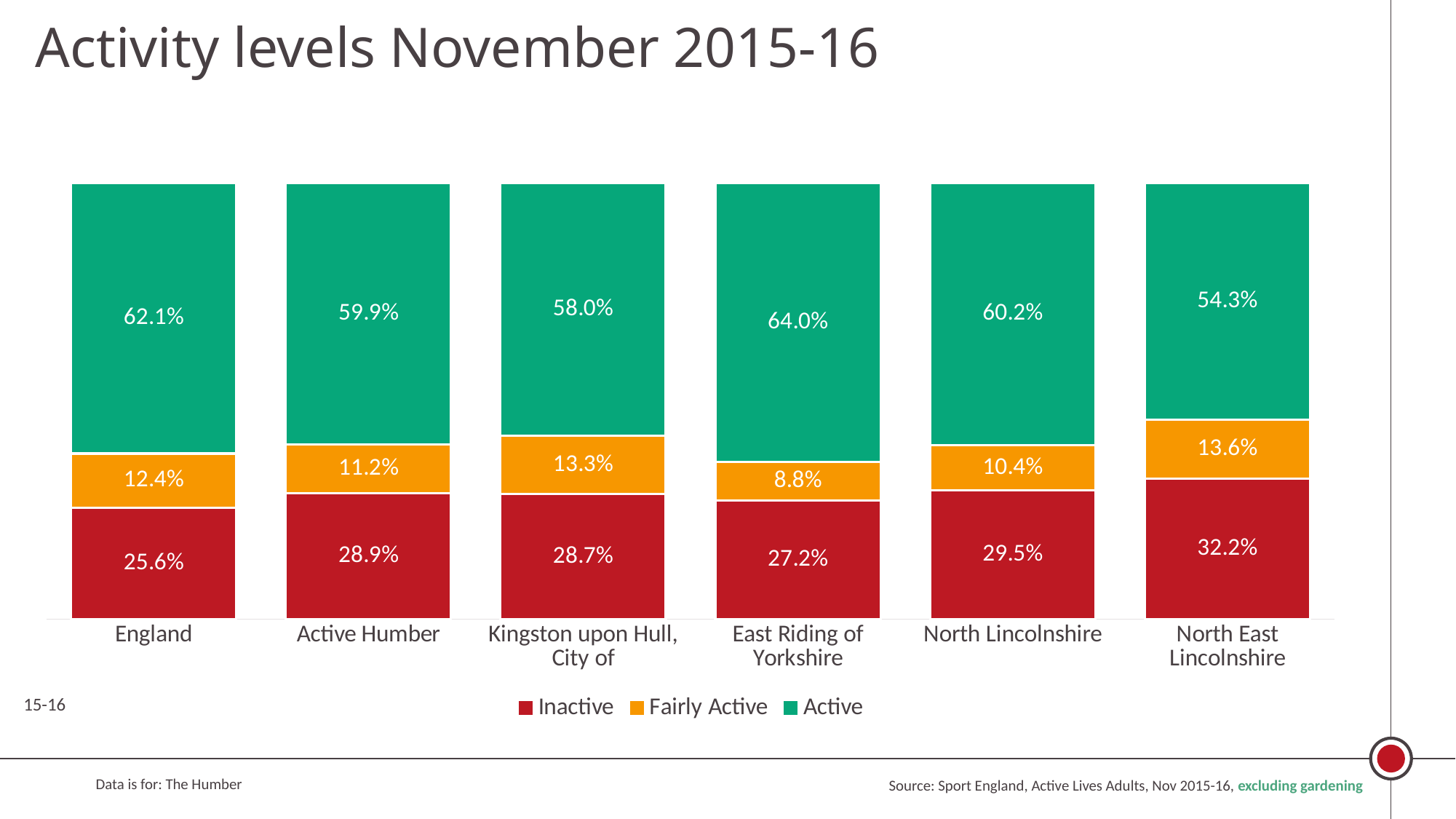
Which area has the lowest Inactive percentage? England How many series does the legend list? 3 What is the Active percentage for Kingston upon Hull, City of? 58.0% What is the difference in percentage points between the Inactive share for North East Lincolnshire and for England? 6.6 Which area has the lowest Fairly Active percentage? East Riding of Yorkshire What is the Fairly Active percentage for East Riding of Yorkshire? 8.8% What is the Inactive percentage for North East Lincolnshire? 32.2% Which has a larger Active percentage, Active Humber or North Lincolnshire? North Lincolnshire What type of chart is shown on the slide? Stacked bar chart Which area has the highest Active percentage? East Riding of Yorkshire How many areas are shown on the x axis? 6 What percentage of adults in England are Active? 62.1%